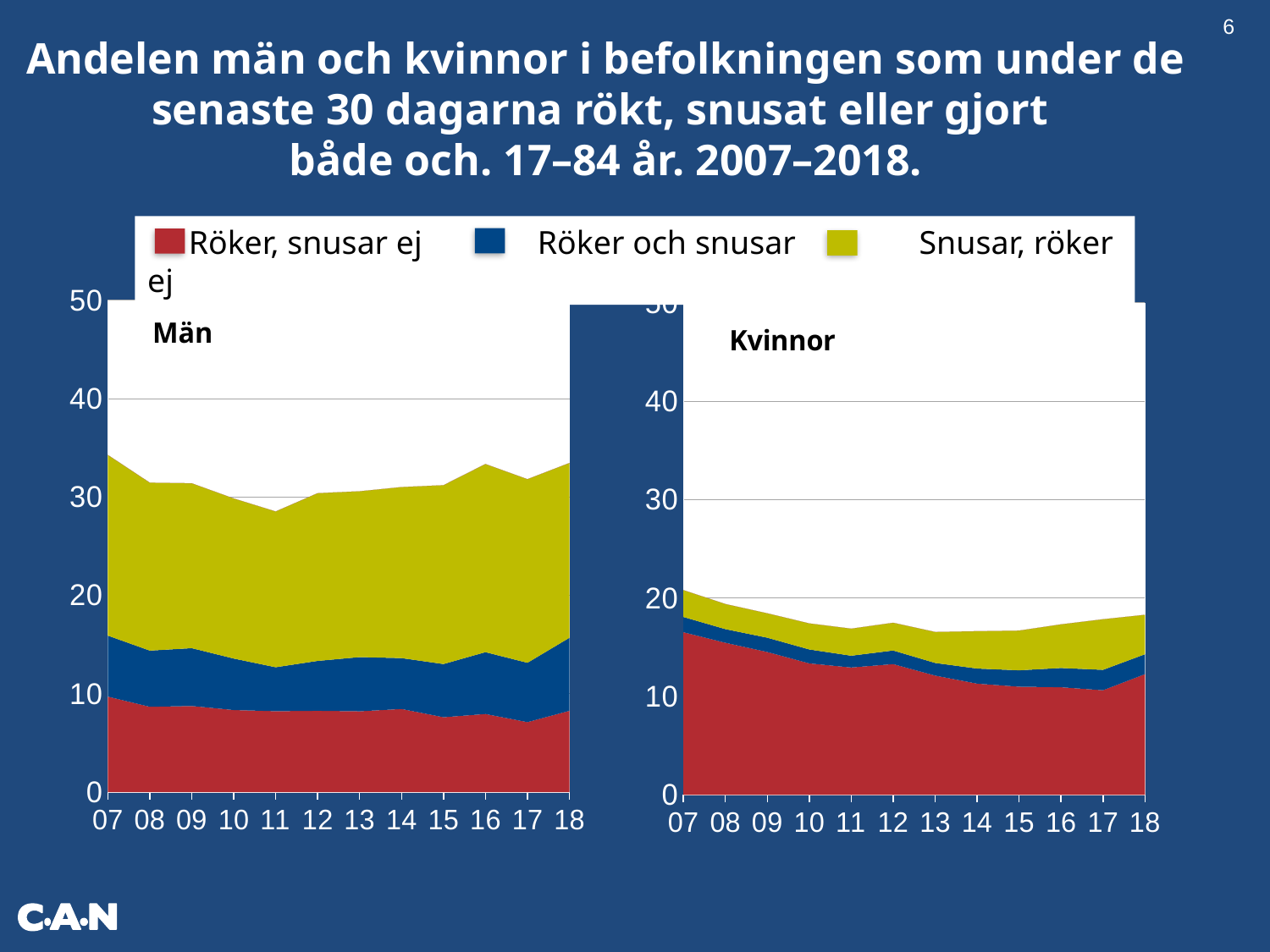
In the "Kvinnor" chart, is the total value for 18 greater or less than 20? less Which chart has the higher total value in 07, "Män" or "Kvinnor"? Män How many series does the legend list? 3 In the "Män" chart, is the total value for 11 greater or less than 30? less How many years are shown on the x axis of the "Kvinnor" chart? 12 In the "Män" chart, is the value for "Röker, snusar ej" in 17 greater or less than 10? less What is the label of the chart on the right? Kvinnor Which legend entry is shown in yellow-green? Snusar, röker ej In the "Kvinnor" chart, does the total value rise or fall from 07 to 17? fall What kind of chart is the "Män" chart? stacked area chart